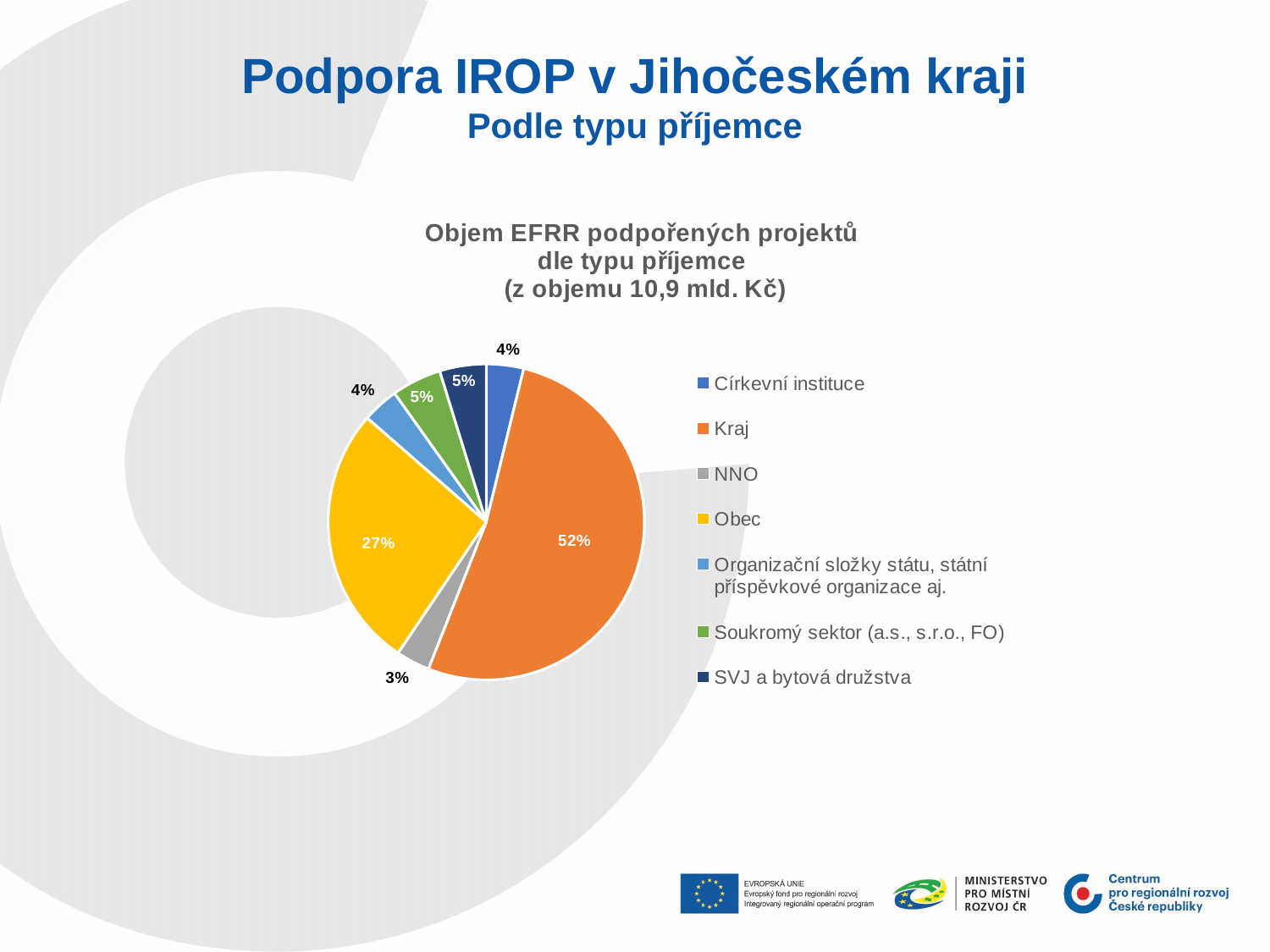
Which has a larger share, Obec or Soukromý sektor (a.s., s.r.o., FO)? Obec What is the difference in percentage points between the shares of Kraj and Obec? 25 What share of the pie does NNO have? 3% What share of the pie does SVJ a bytová družstva have? 5% Which category has the smallest share of the pie? NNO Which category has the largest share of the pie? Kraj What is the title of the chart? Objem EFRR podpořených projektů dle typu příjemce (z objemu 10,9 mld. Kč) What share of the pie does Kraj have? 52% What kind of chart is shown on the slide? pie chart How many categories does the legend list? 7